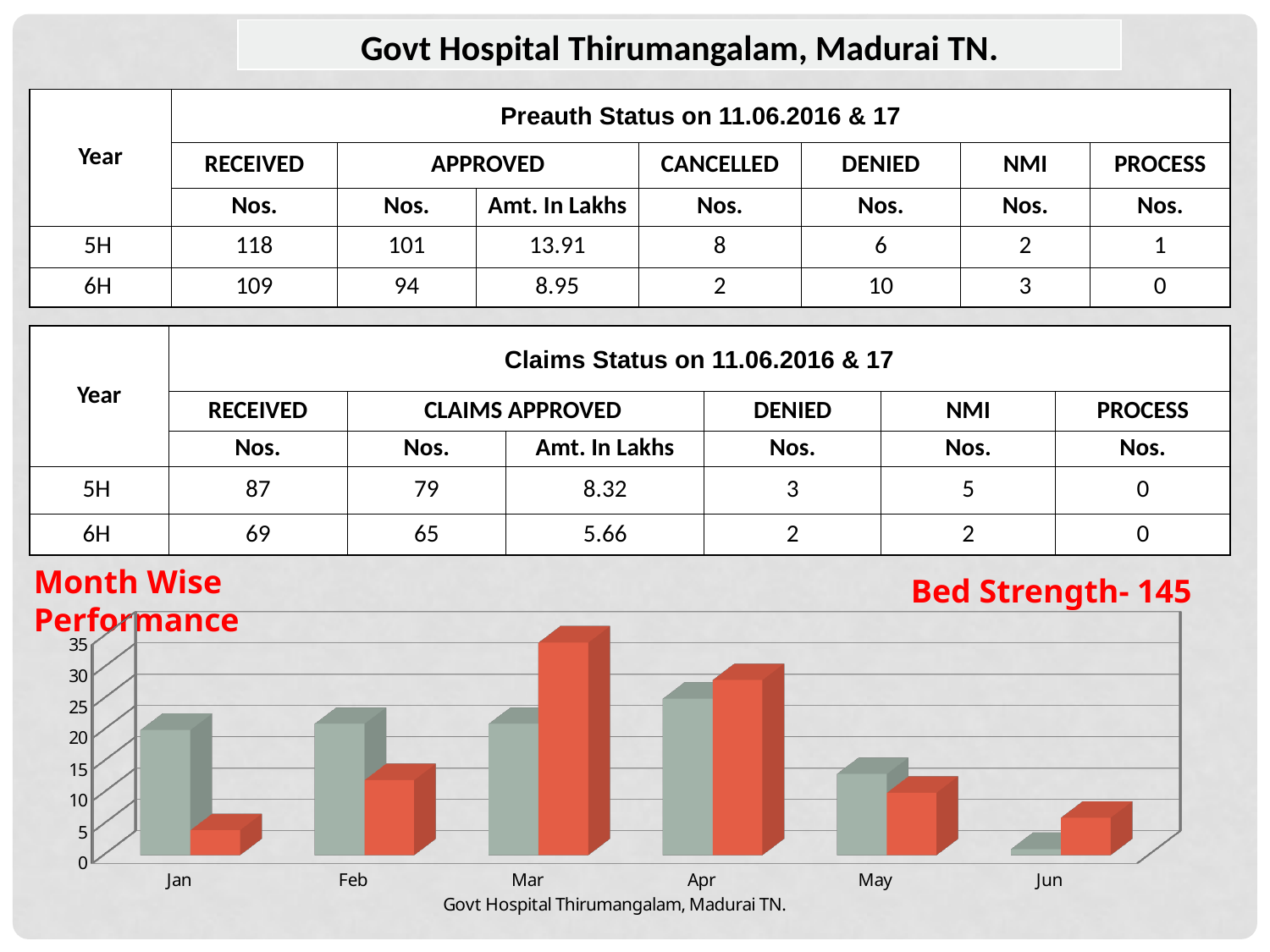
In the Month Wise Performance chart, which month has the shortest red bar? Jan In the Month Wise Performance chart, which bar is taller for Mar, the grey bar or the red bar? The red bar How many months are shown on the x axis of the Month Wise Performance chart? 6 In the Month Wise Performance chart, which month has the shortest grey bar? Jun In the Month Wise Performance chart, is the grey bar for Jun greater or less than 5? less In the Month Wise Performance chart, is the grey bar for Jan greater or less than 15? greater In the Month Wise Performance chart, is the red bar for Jan greater or less than 10? less In the Month Wise Performance chart, which month has the tallest red bar? Mar What text appears as the title beneath the Month Wise Performance chart? Govt Hospital Thirumangalam, Madurai TN. What kind of chart is shown at the bottom of the slide? Bar chart How many bars are plotted for each month in the Month Wise Performance chart? 2